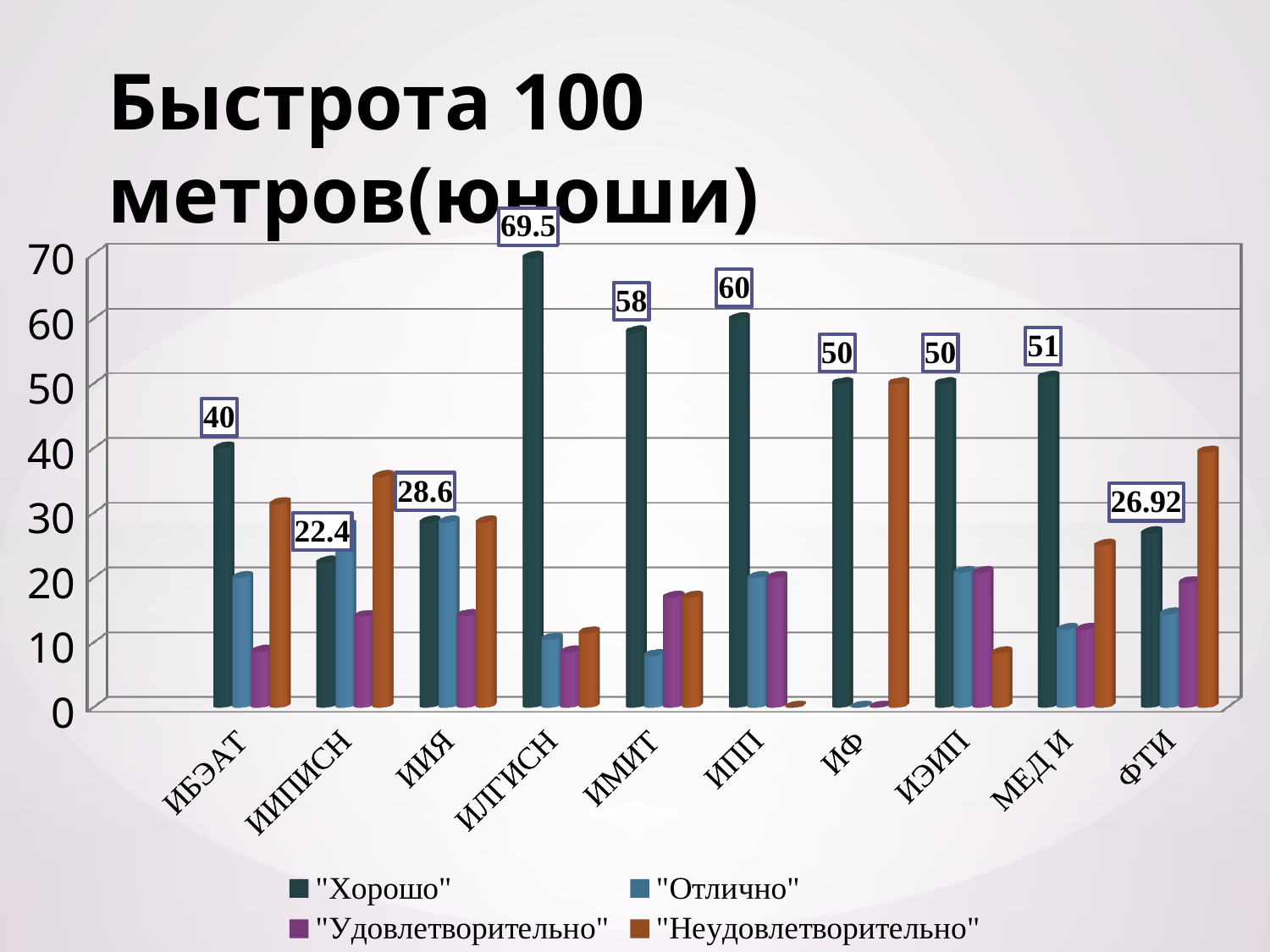
Which category has the highest "Хорошо" value? ИЛГИСН What is the value of the "Хорошо" series for ИЛГИСН? 69.5 Is the "Отлично" value for ИМИТ greater or less than 10? less How many series does the legend list? 4 Which has the larger "Хорошо" value, ИБЭАТ or ИИЯ? ИБЭАТ What is the value of the "Хорошо" series for ФТИ? 26.92 What kind of chart is shown on the slide? bar chart Is the "Неудовлетворительно" value for ФТИ greater or less than 30? greater How many categories are shown on the x axis? 10 Which category has the lowest "Хорошо" value? ИИПИСН What is the difference between the "Хорошо" values for ИПП and ИМИТ? 2 What is the difference between the highest and lowest "Хорошо" values (ИЛГИСН and ИИПИСН)? 47.1